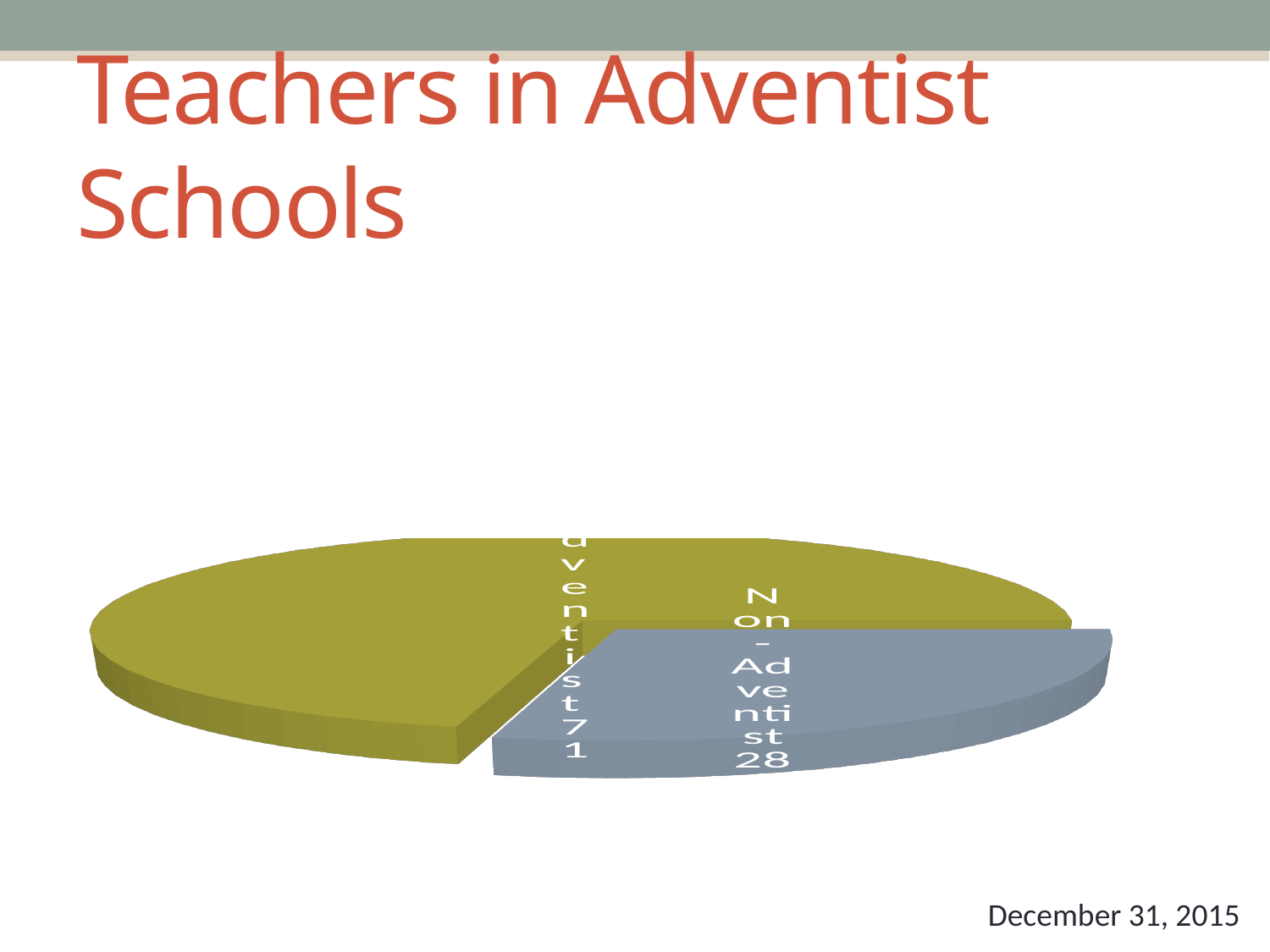
What colour is the Non-Adventist slice of the pie chart? grey-blue How many slices does the pie chart have? 2 Which slice of the pie is the largest? Adventist What is the title of the slide containing the pie chart? Teachers in Adventist Schools What is the value shown for the Non-Adventist slice? 28 What is the value shown for the Adventist slice? 71 What is the sum of the two values shown on the pie chart? 99 What kind of chart is shown on the slide? pie chart What is the difference between the Adventist value and the Non-Adventist value? 43 Which slice of the pie is the smallest? Non-Adventist Which is larger, the Adventist value or the Non-Adventist value? Adventist